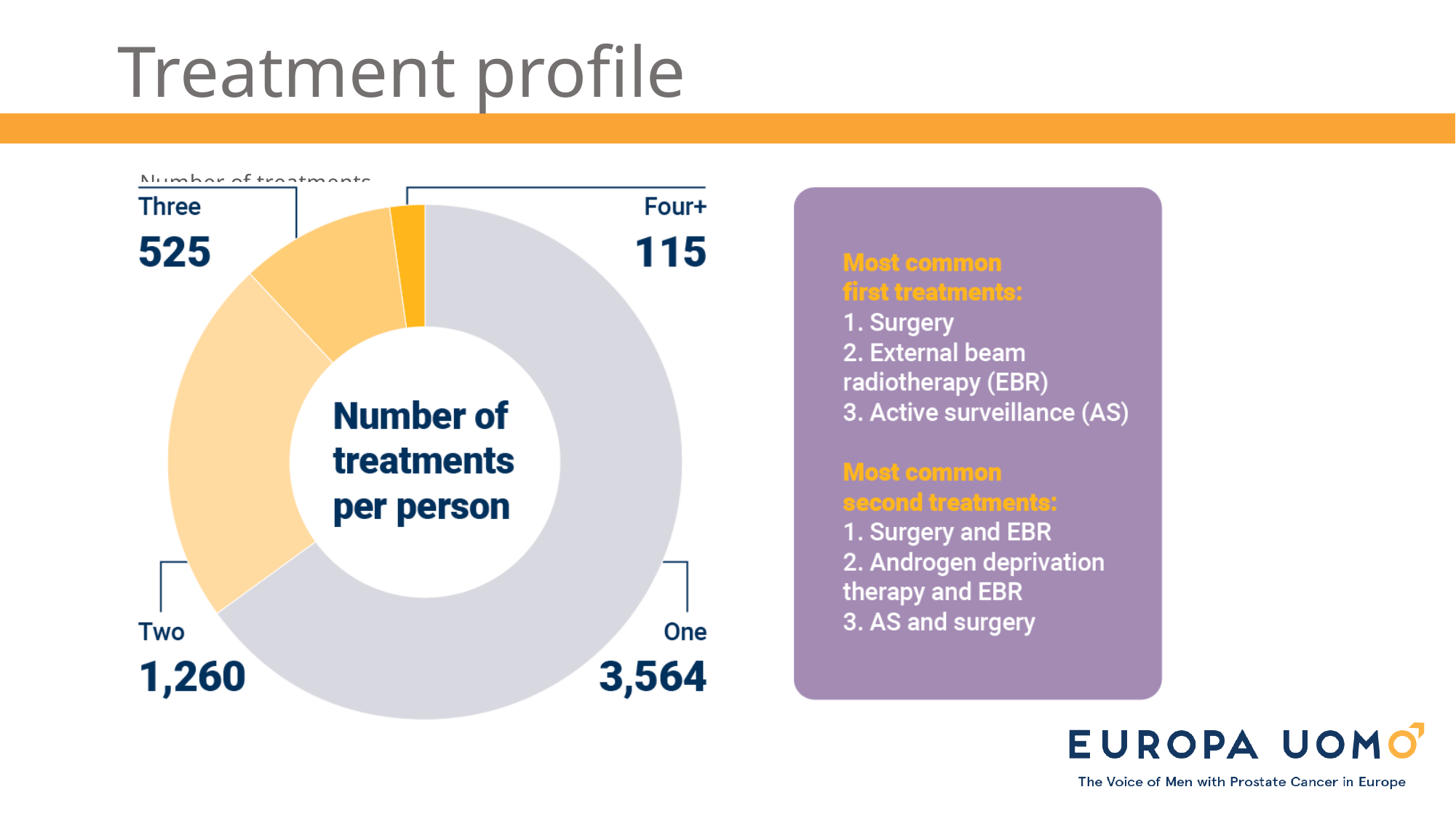
How many people had one treatment according to the donut chart? 3,564 What is the value shown for the 'Two' treatments segment? 1,260 Which number-of-treatments category has the largest value? One What is the difference between the 'One' and 'Two' values? 2,304 What kind of chart is used to show the number of treatments per person? Donut (pie) chart What is the total of all four segments in the donut chart? 5,464 Which is larger, the value for 'Two' or the value for 'Three'? Two What is the difference between the 'Three' and 'Four+' values? 410 How many categories does the donut chart show? 4 What is the value shown for the 'Four+' treatments segment? 115 Which number-of-treatments category has the smallest value? Four+ What is the value shown for the 'Three' treatments segment? 525